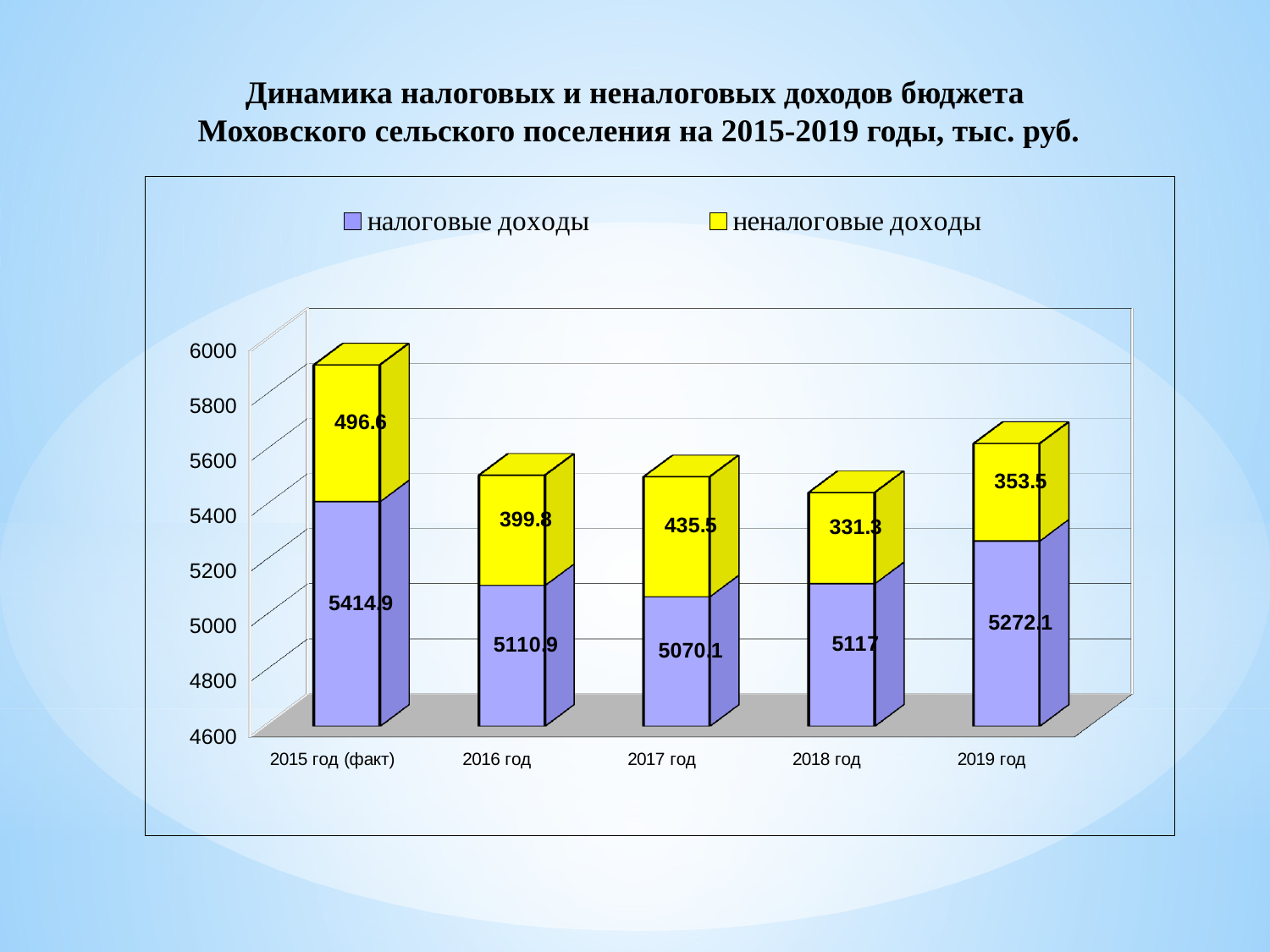
How many series does the legend list? 2 Which colour represents неналоговые доходы in the legend? Yellow What is the value of налоговые доходы for 2018 год? 5117 Which is larger: неналоговые доходы in 2016 год or in 2019 год? 2016 год What is the difference between налоговые доходы in 2019 год and 2018 год? 155.1 What kind of chart is shown on the slide? Stacked bar chart Which year has the highest value of неналоговые доходы? 2015 год (факт) What is the value of налоговые доходы for 2015 год (факт)? 5414.9 What is the value of неналоговые доходы for 2017 год? 435.5 How many years are shown on the x axis? 5 Which year has the lowest value of налоговые доходы? 2017 год What is the total of налоговые доходы and неналоговые доходы for 2016 год? 5510.7